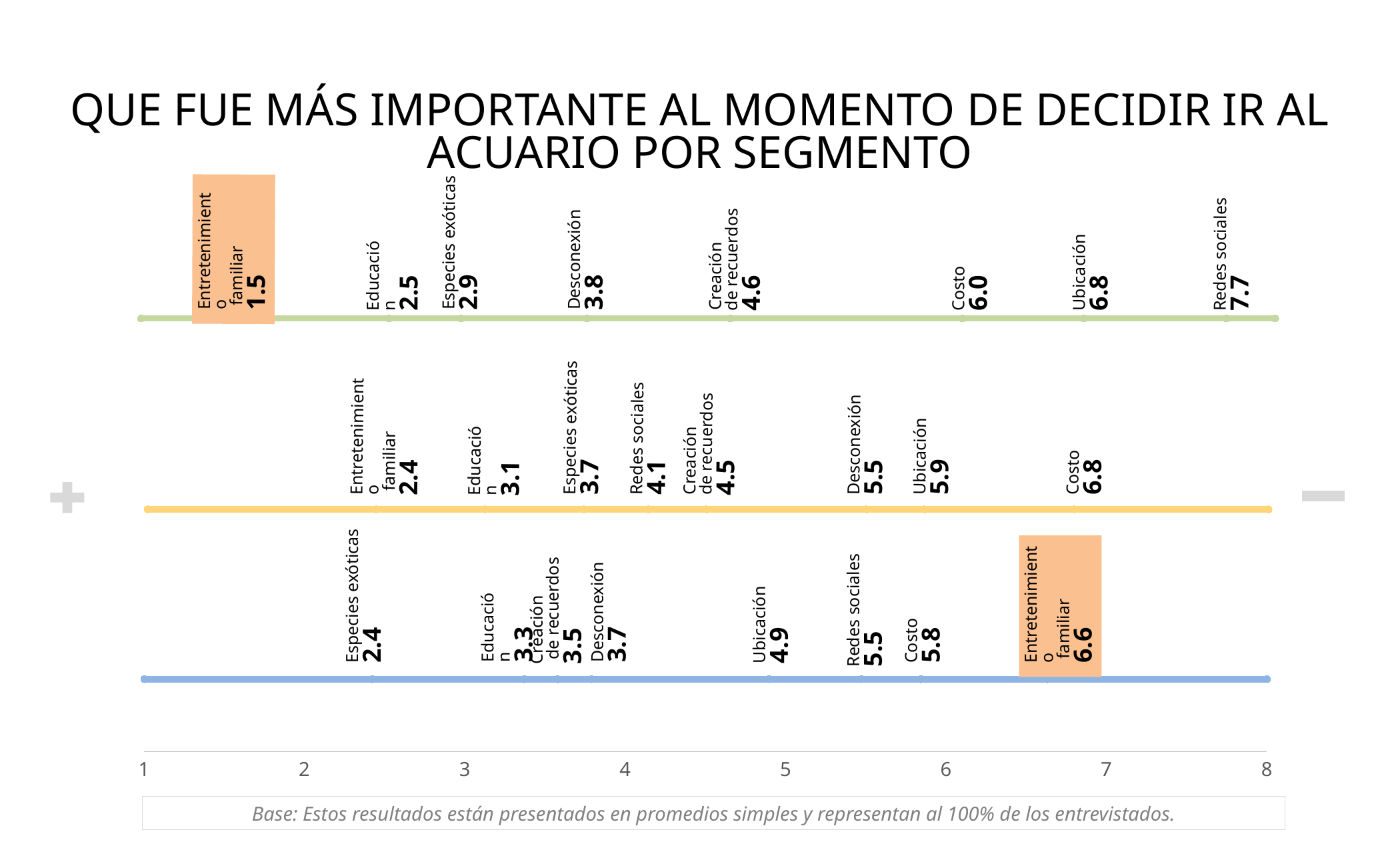
On the top (green) line, which category has the lowest value? Entretenimiento familiar How many categories are plotted on each line? 8 On the bottom (blue) line, what is the value for Ubicación? 4.9 What is the difference between the value for Costo on the middle (yellow) line and on the bottom (blue) line? 1.0 On the middle (yellow) line, which is larger: the value for Desconexión or the value for Redes sociales? Desconexión On the bottom (blue) line, which category has the highest value? Entretenimiento familiar What is the difference between the value for Entretenimiento familiar on the bottom (blue) line and on the top (green) line? 5.1 On the top (green) line, what is the value for Redes sociales? 7.7 On the middle (yellow) line, what is the value for Costo? 6.8 On the top (green) line, is the value for Costo greater or less than 5? greater How many horizontal lines (segments) are shown on the chart? 3 On the middle (yellow) line, which category has the lowest value? Entretenimiento familiar